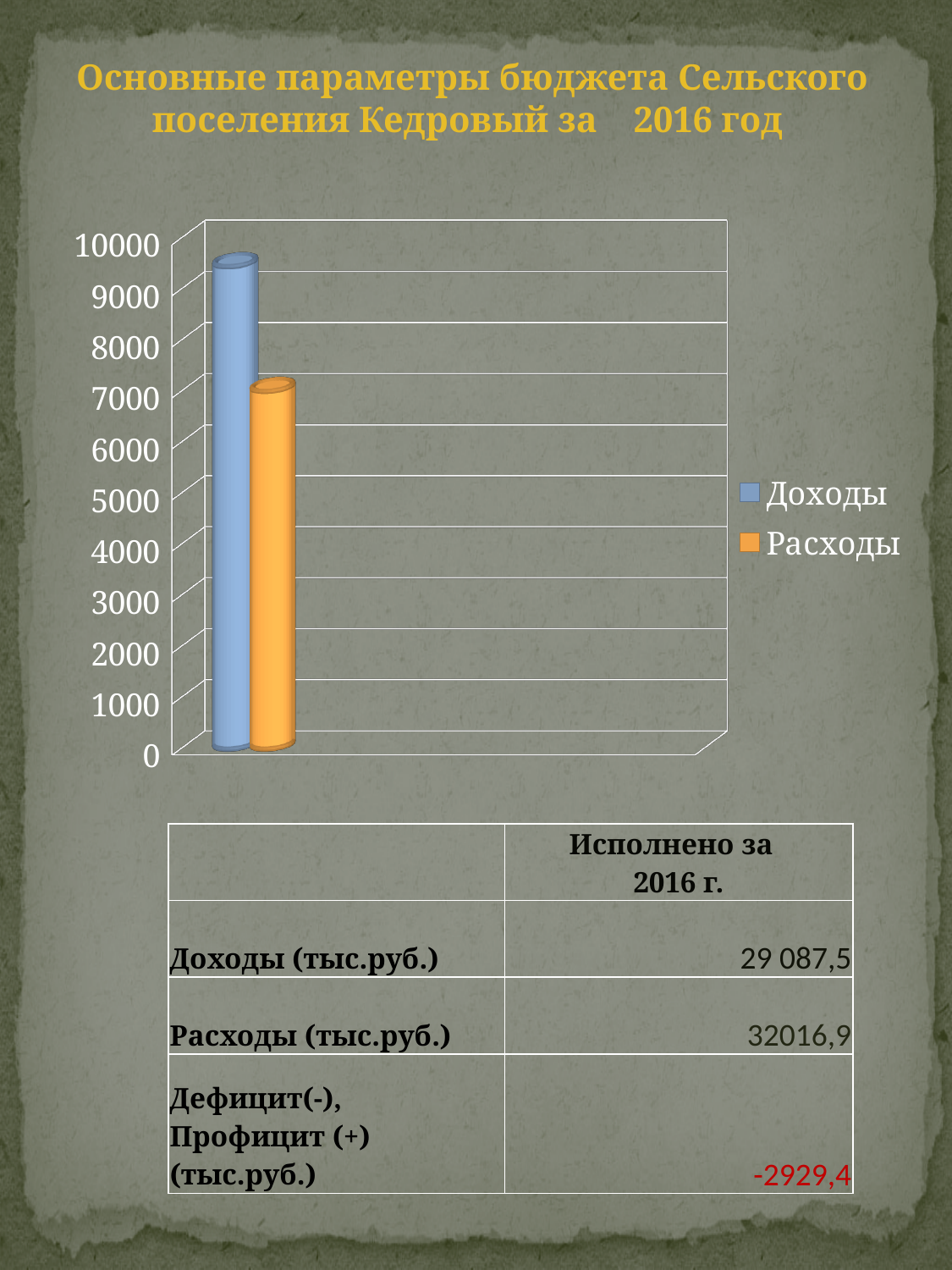
What kind of chart is shown on the slide? bar chart Is the value for Доходы in the chart greater or less than 9000? greater What colour is the bar for Расходы in the chart? orange How many series does the chart legend list? 2 Is the value for Доходы in the chart greater or less than 10000? less Which series has the highest value in the chart? Доходы What are the two entries listed in the chart legend? Доходы, Расходы Is the value for Расходы in the chart greater or less than 8000? less Which series has the taller bar in the chart, Доходы or Расходы? Доходы How many bars are plotted in the chart? 2 Which series has the lowest value in the chart? Расходы